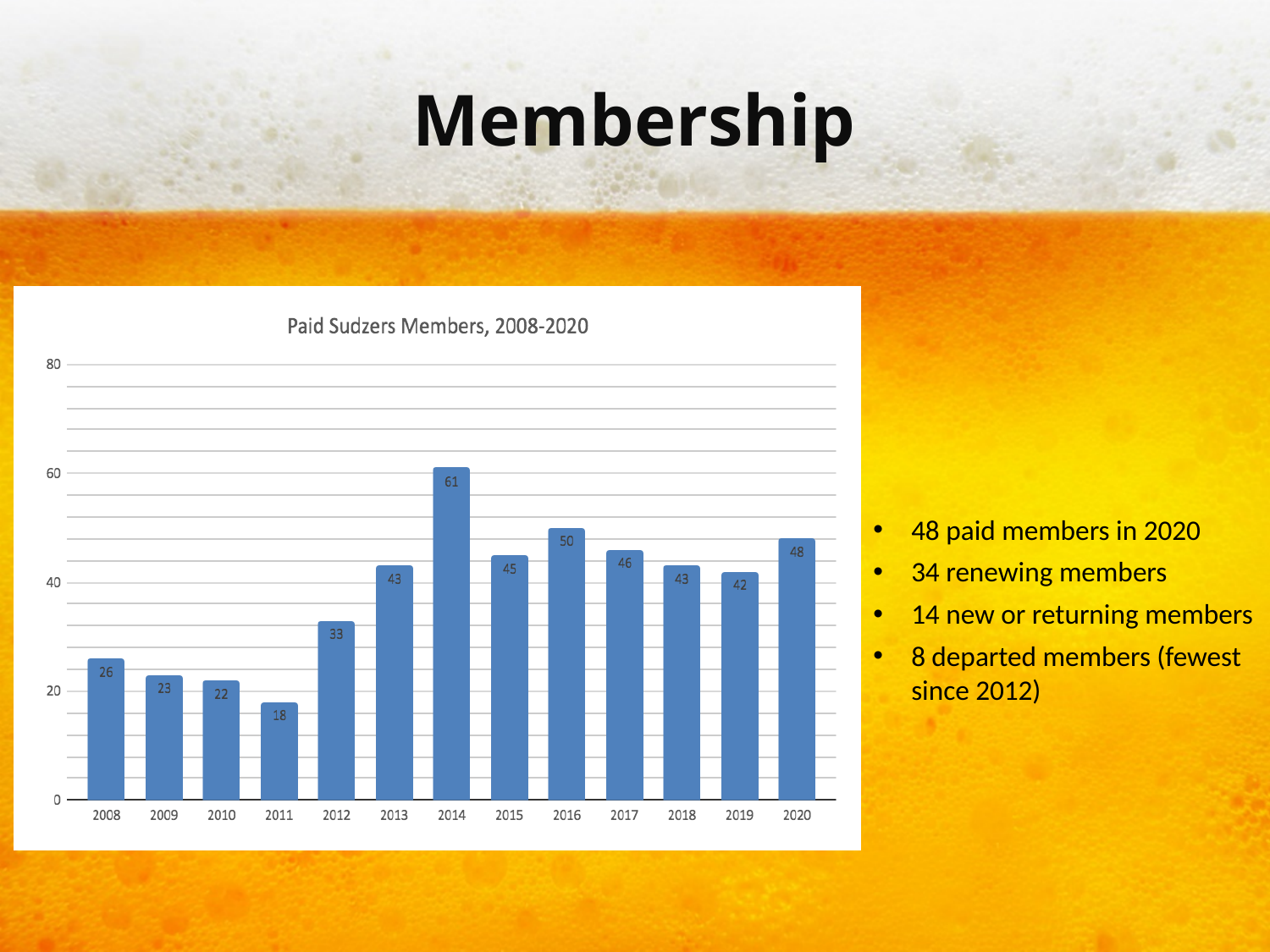
How many years are shown on the x axis of the chart? 13 Which year had the highest number of paid members? 2014 Which year had the lowest number of paid members? 2011 What kind of chart is shown on the slide? bar chart How many paid members were there in 2020? 48 Did the number of paid members rise or fall from 2008 to 2011? fall How many paid members were there in 2011? 18 Is the value for 2012 greater or less than 40? less How many paid members were there in 2014? 61 What is the difference in paid members between 2014 and 2020? 13 What is the title of the chart? Paid Sudzers Members, 2008-2020 Which year had more paid members, 2016 or 2017? 2016